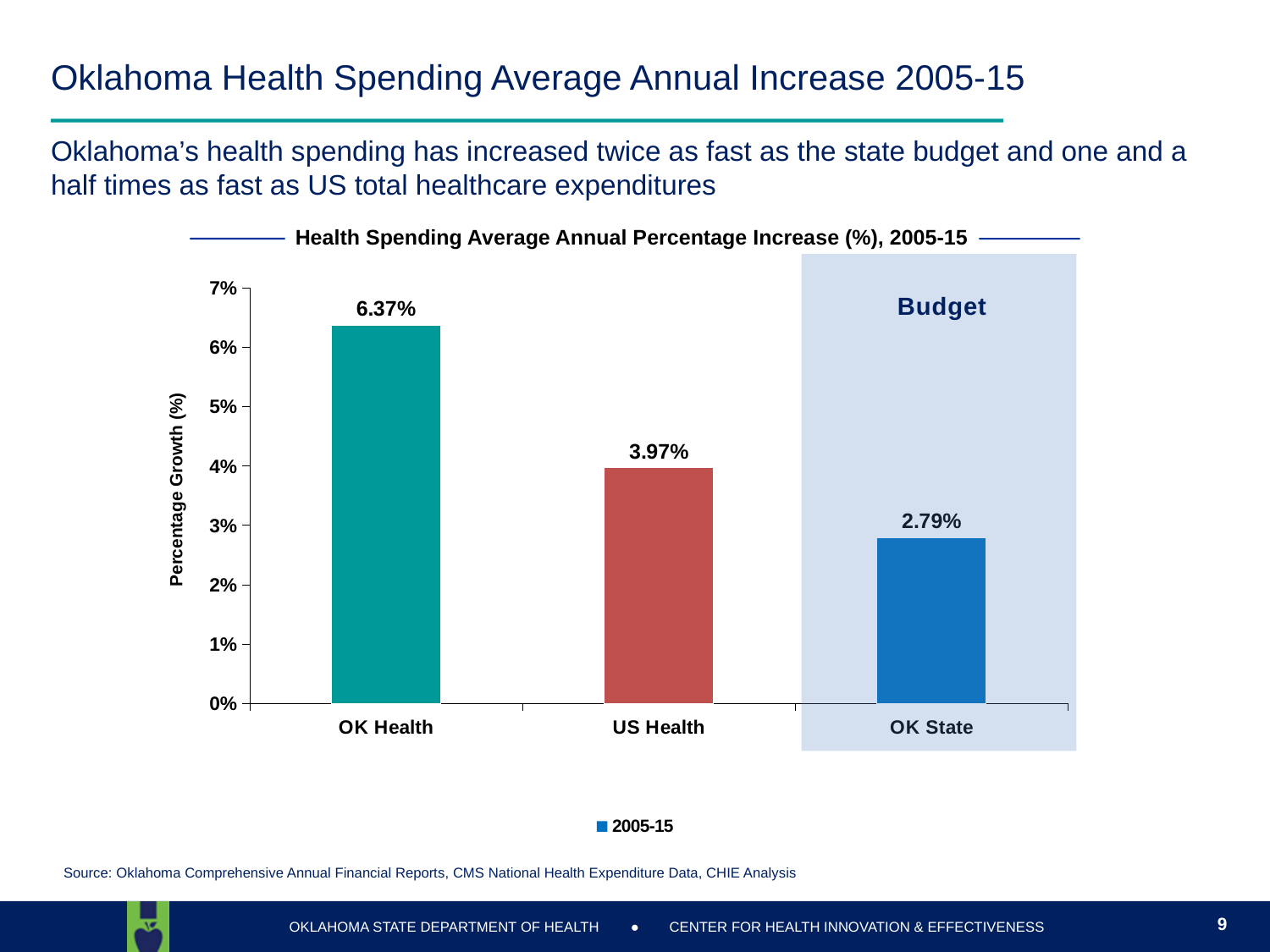
How many categories are shown on the x axis? 3 Is the value for OK Health greater or less than 6%? greater What is the difference between the values for OK Health and US Health? 2.40% Which is larger, the value for US Health or the value for OK State? US Health What is the value for OK Health? 6.37% Which category has the highest average annual percentage increase? OK Health What kind of chart is shown on the slide? bar chart What is the value for US Health? 3.97% What is the title of the chart? Health Spending Average Annual Percentage Increase (%), 2005-15 What is the value for OK State? 2.79% What is the difference between the values for US Health and OK State? 1.18% Which category has the lowest average annual percentage increase? OK State